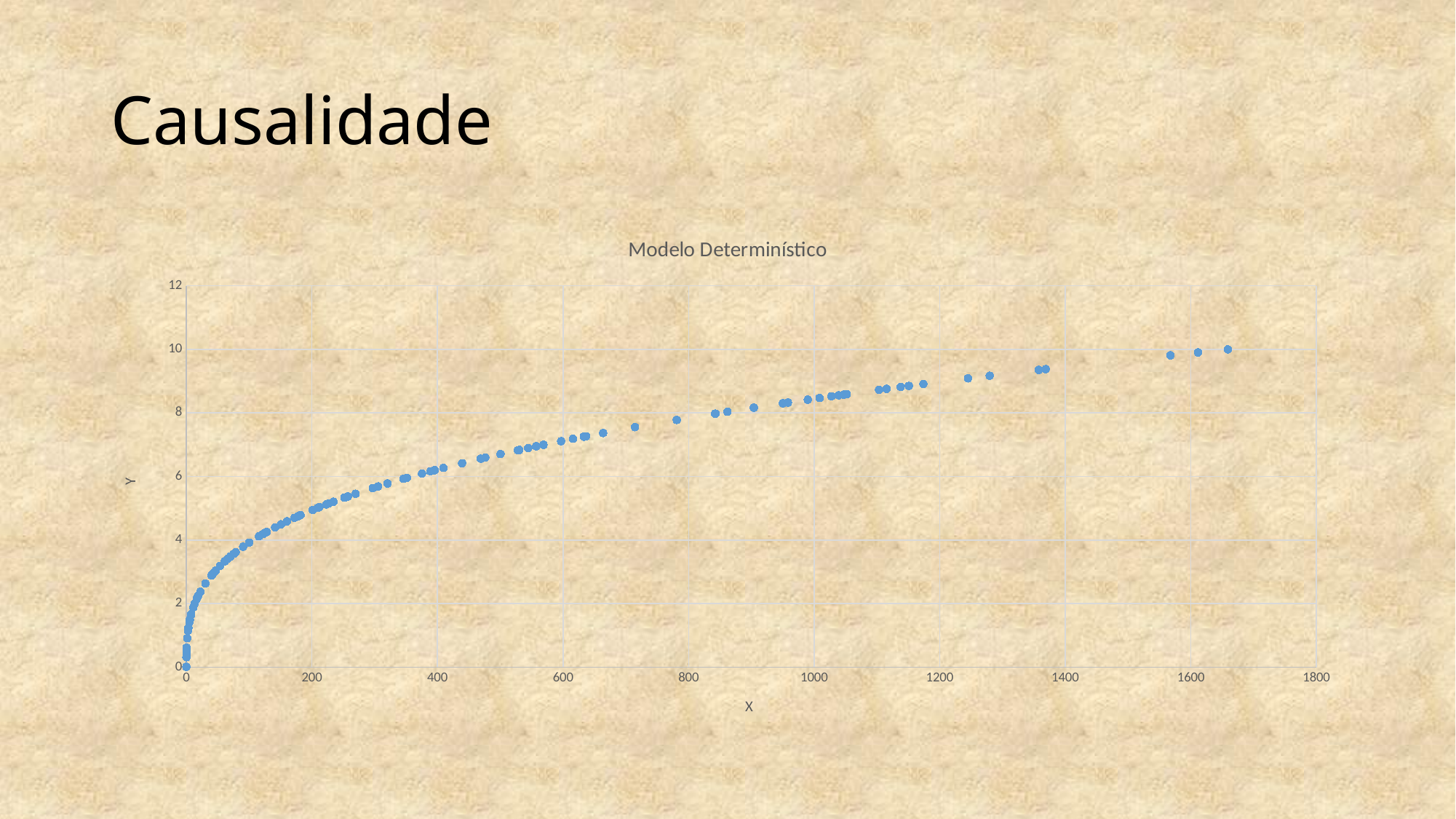
What kind of chart is shown on the slide? Scatter chart Is the Y value of the point near X = 800 greater or less than 10? less Which has the larger Y value: the point near X = 600 or the point near X = 1400? The point near X = 1400 Is the Y value of the rightmost point (near X = 1650) greater or less than 8? greater What are the labels of the horizontal and vertical axes of the chart? X and Y Does the curve of points rise more steeply at low values of X or at high values of X? Low values of X Is the Y value of the point near X = 200 greater or less than 6? less What is the title of the chart? Modelo Determinístico Do the Y values rise or fall as X increases along the x axis? Rise